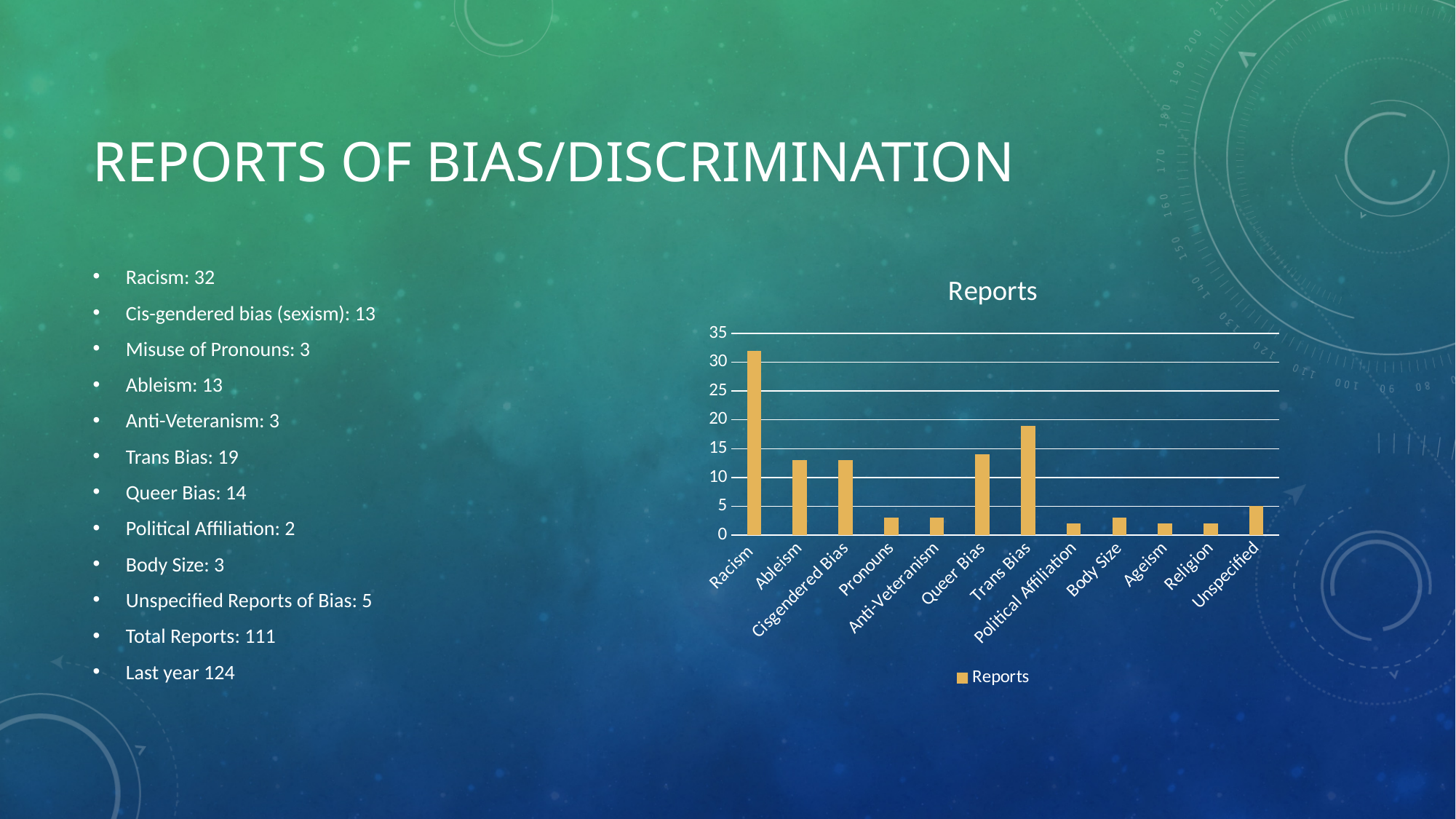
Is the value for Trans Bias greater or less than 15? greater Which category has the highest bar in the chart? Racism How many categories are shown on the x axis of the chart? 12 What is the title of the chart? Reports What kind of chart is shown on the slide? bar chart How many series does the chart legend list? 1 Is the value for Pronouns greater or less than 5? less Which is larger, the value for Trans Bias or the value for Queer Bias? Trans Bias Is the value for Racism greater or less than 30? greater Which is larger, the value for Racism or the value for Trans Bias? Racism What is the value for Unspecified in the chart? 5